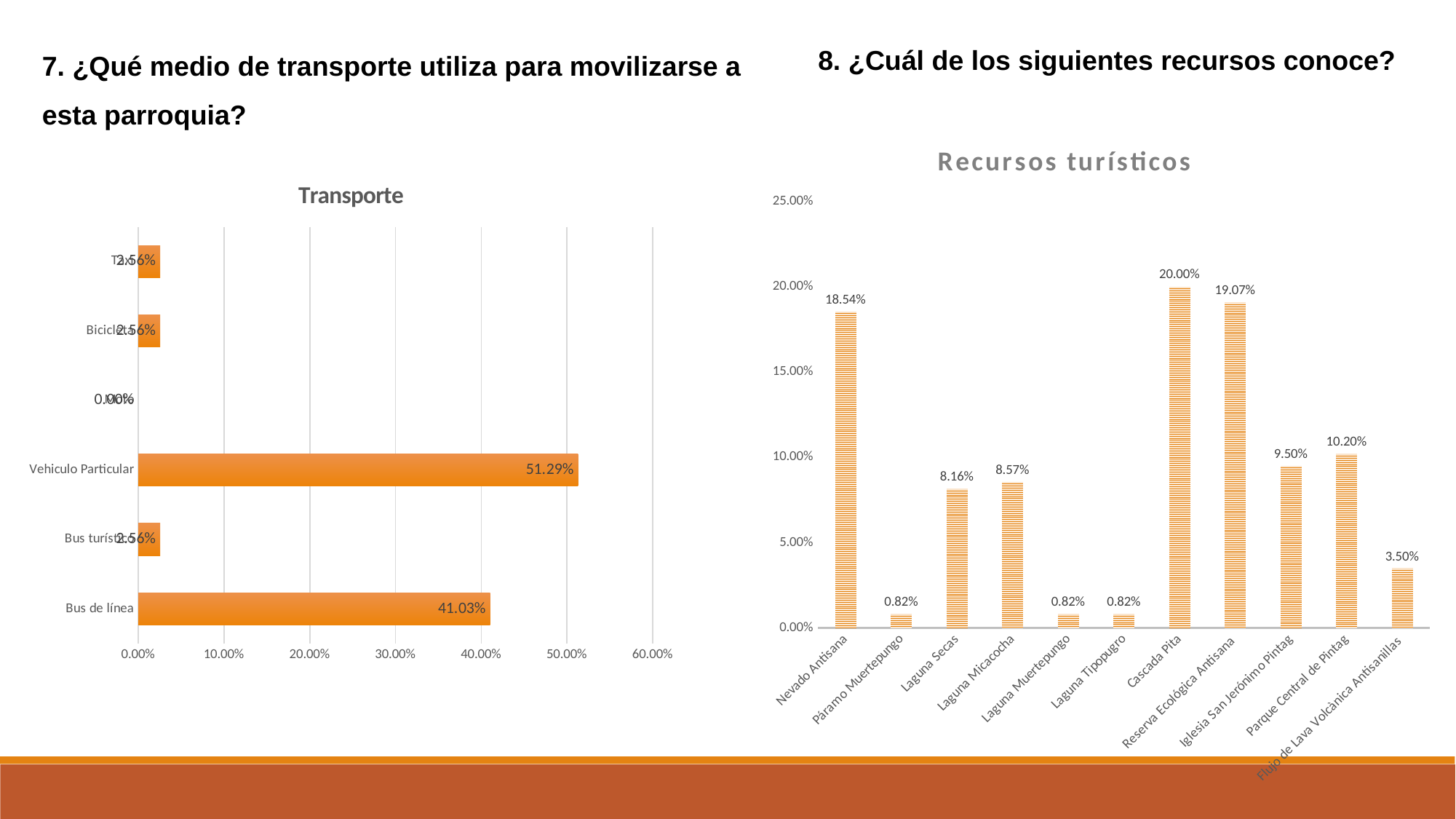
In the Recursos turísticos chart, which category has the highest value? Cascada Pita What kind of chart is the Transporte chart? Bar chart In the Transporte chart, which category has the highest value? Vehiculo Particular In the Recursos turísticos chart, what is the difference between Reserva Ecológica Antisana and Nevado Antisana? 0.53% In the Transporte chart, what is the value for Vehiculo Particular? 51.29% In the Transporte chart, what is the difference between Vehiculo Particular and Bus de línea? 10.26% In the Recursos turísticos chart, what is the value for Cascada Pita? 20.00% In the Transporte chart, what is the value for Bus de línea? 41.03% In the Recursos turísticos chart, what is the value for Laguna Micacocha? 8.57% In the Recursos turísticos chart, how many categories are shown on the x axis? 11 In the Recursos turísticos chart, which is larger, Parque Central de Pintag or Iglesia San Jerónimo Pintag? Parque Central de Pintag What is the title of the chart on the right side of the slide? Recursos turísticos